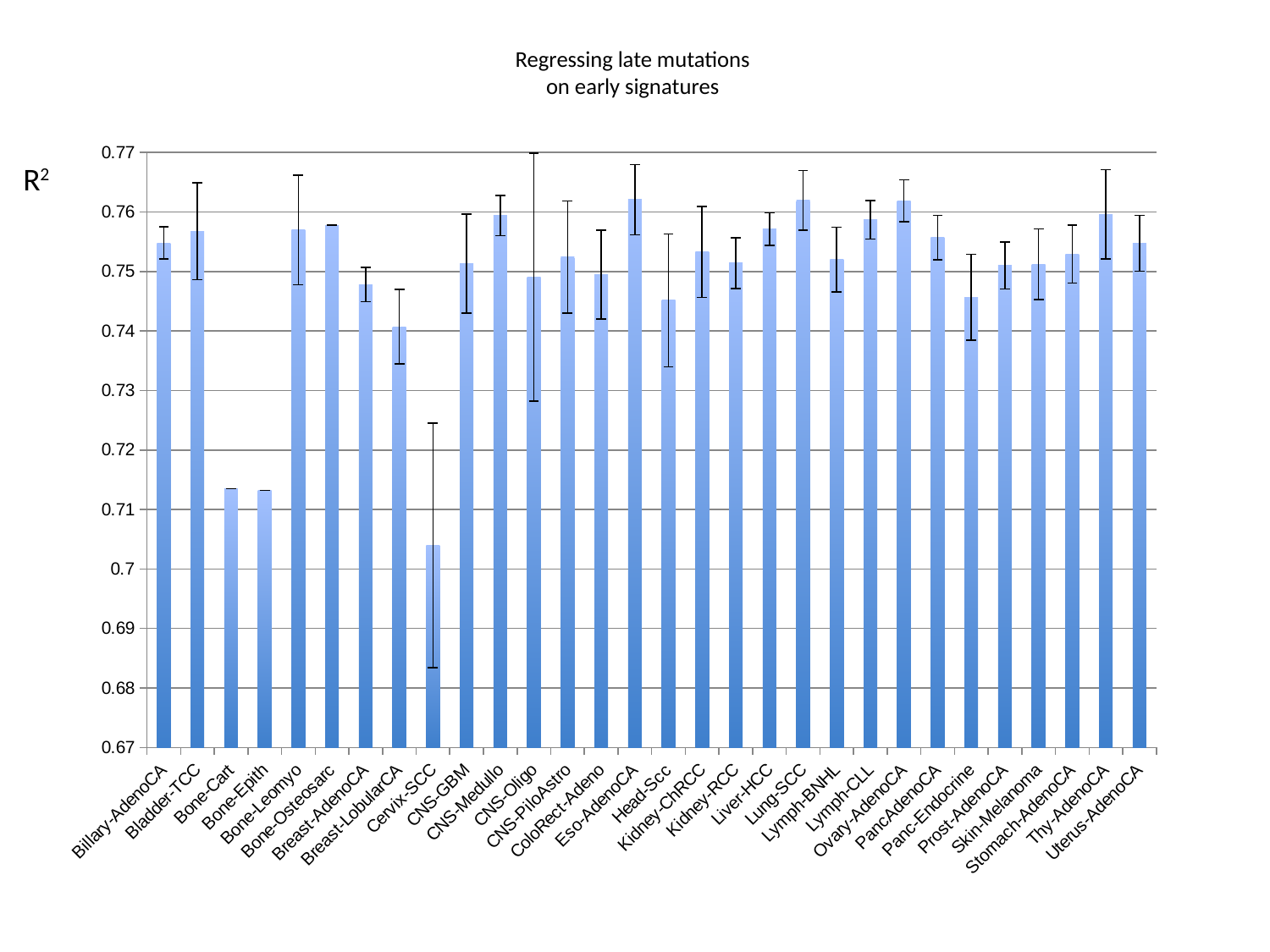
Which category has the lowest value? Cervix-SCC Which is larger, the value for Bone-Cart or the value for Cervix-SCC? Bone-Cart What label is shown on the vertical axis of the chart? R² What is the title of the chart? Regressing late mutations on early signatures Is the value for Cervix-SCC greater or less than 0.71? less Is the value for Bladder-TCC greater or less than 0.76? less Is the value for Head-Scc greater or less than 0.75? less Which is larger, the value for Bone-Leomyo or the value for Breast-LobularCA? Bone-Leomyo How many categories are plotted along the x axis? 30 What kind of chart is shown on the slide? bar chart